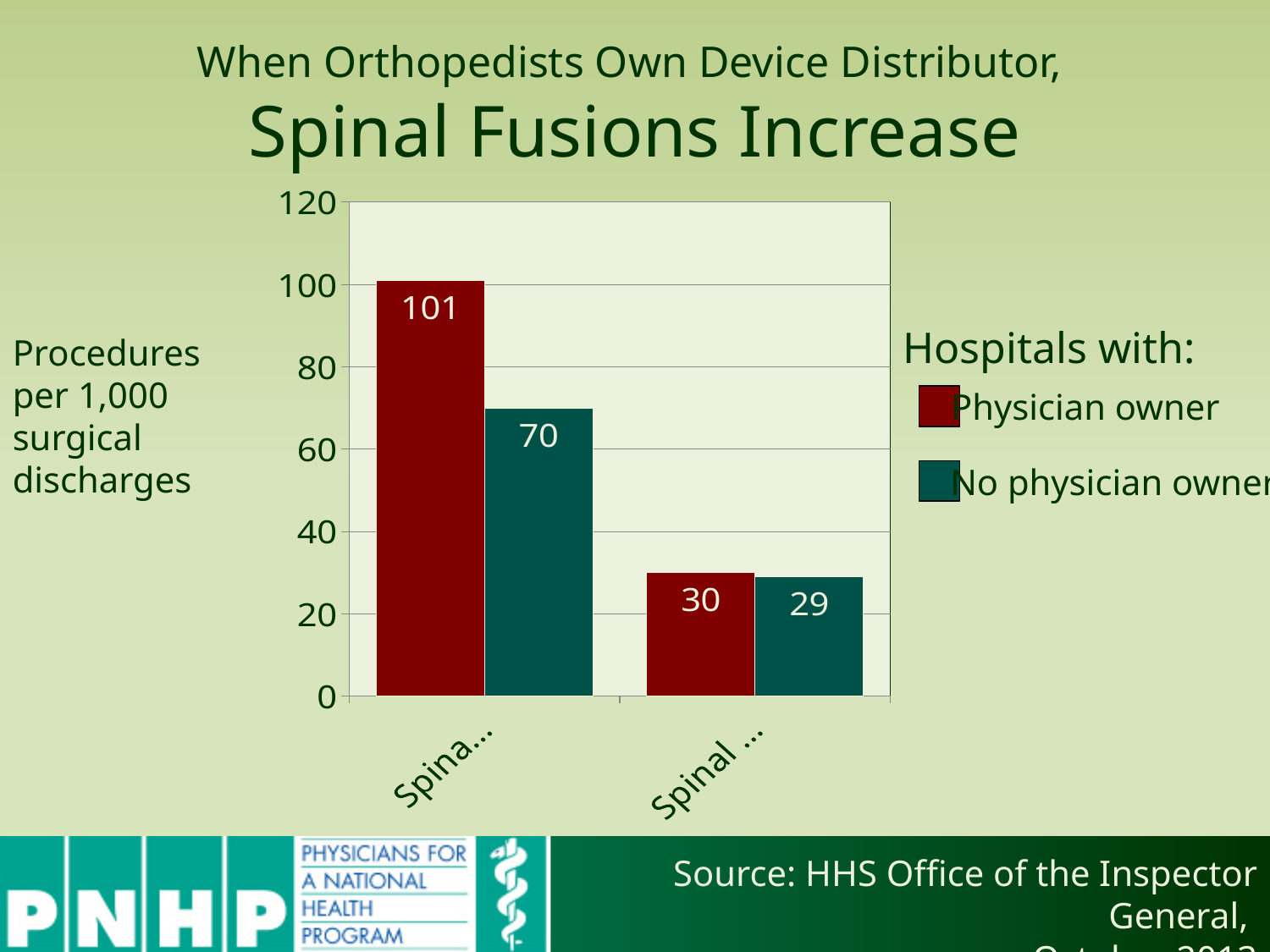
How many series does the legend list? 2 What is the value of the Physician owner bar for the right-hand category? 30 What is the lowest value shown on the chart? 29 What is the value of the Physician owner bar for the left-hand category? 101 What unit is the chart's vertical axis measured in, according to the label to the left of the chart? Procedures per 1,000 surgical discharges What is the value of the No physician owner bar for the right-hand category? 29 For the left-hand category, which series has the larger value: Physician owner or No physician owner? Physician owner For the right-hand category, what is the difference between the Physician owner and No physician owner values? 1 For the left-hand category, what is the difference between the Physician owner and No physician owner values? 31 What kind of chart is shown on the slide? Bar chart What is the value of the No physician owner bar for the left-hand category? 70 What is the highest value shown on the chart? 101